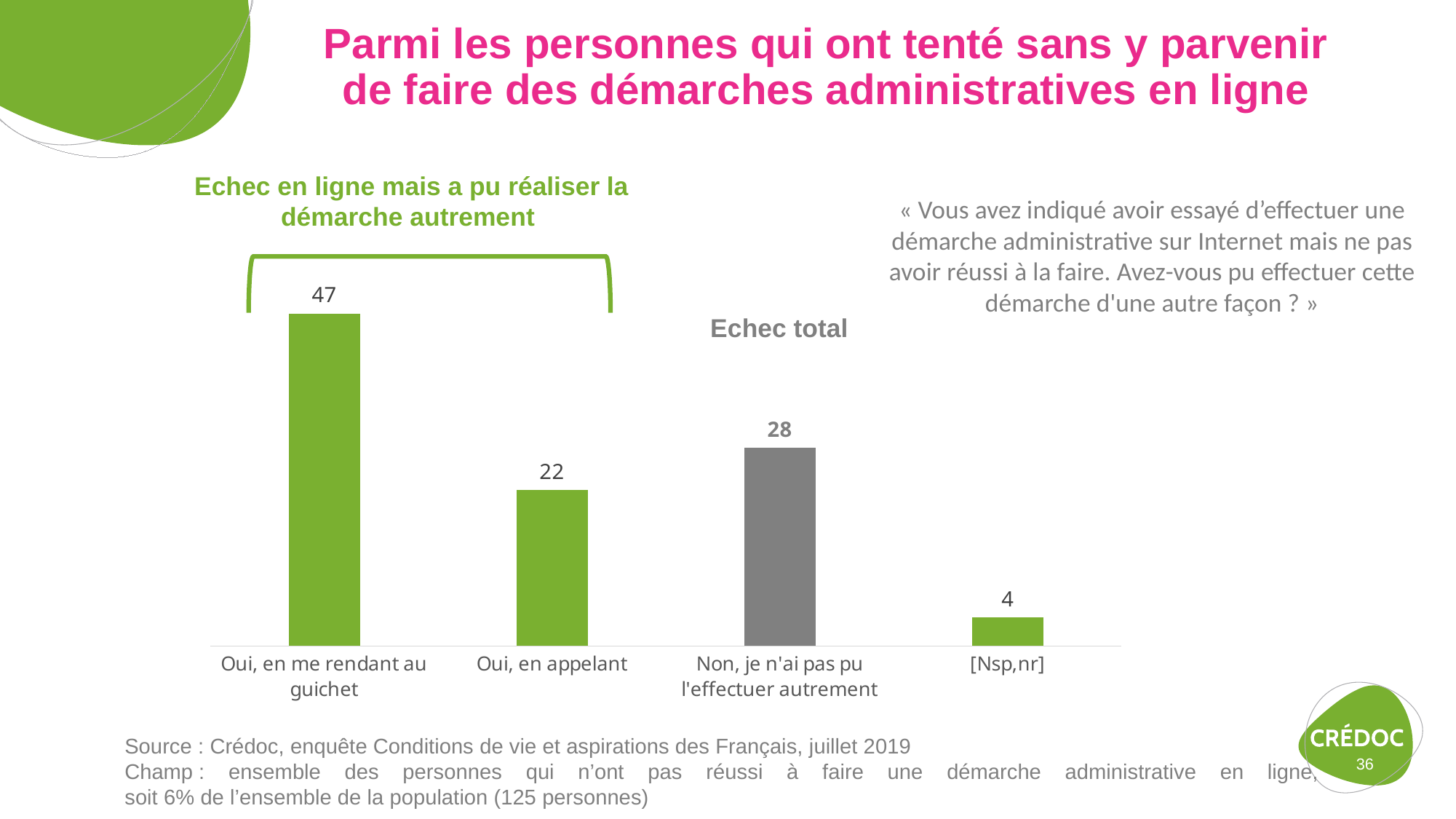
What is the value for "[Nsp,nr]"? 4 What is the value for "Oui, en appelant"? 22 What is the value for "Non, je n'ai pas pu l'effectuer autrement"? 28 How many categories are shown on the x axis? 4 What is the value for "Oui, en me rendant au guichet"? 47 Which bar is coloured grey rather than green? Non, je n'ai pas pu l'effectuer autrement Which category has the highest value? Oui, en me rendant au guichet What kind of chart is shown on the slide? Bar chart Which is larger: the value for "Non, je n'ai pas pu l'effectuer autrement" or the value for "Oui, en appelant"? Non, je n'ai pas pu l'effectuer autrement What is the difference between the values for "Oui, en me rendant au guichet" and "Oui, en appelant"? 25 What is the combined value of the two categories grouped under "Echec en ligne mais a pu réaliser la démarche autrement"? 69 Which category has the lowest value? [Nsp,nr]